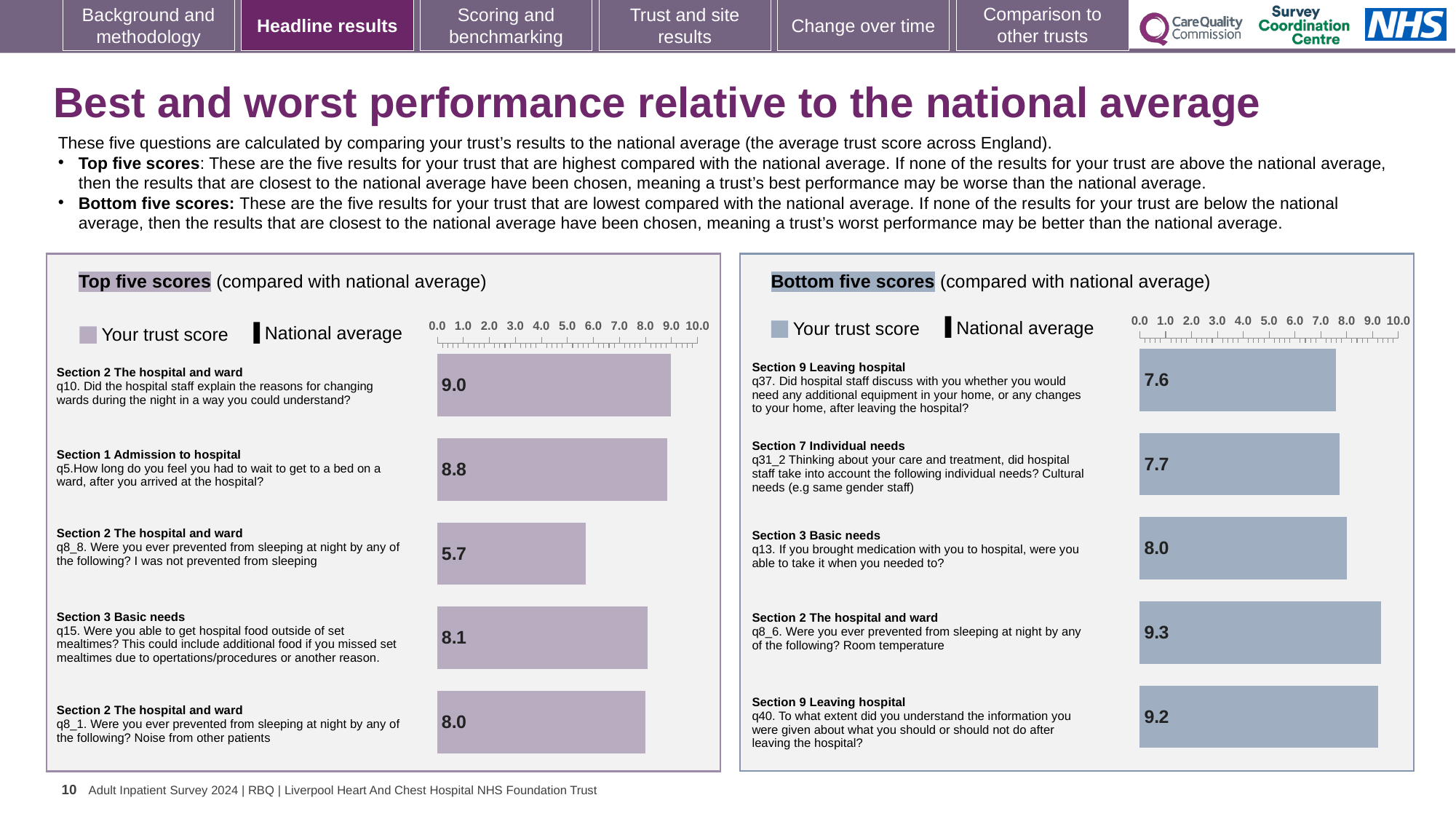
In the Bottom five scores chart, is the trust score for q13 (medication) larger or smaller than the trust score for q40 (understanding information after leaving hospital)? smaller In the Top five scores chart, how many questions are plotted? 5 In the Top five scores chart, which question has the lowest trust score? q8_8. Were you ever prevented from sleeping at night by any of the following? I was not prevented from sleeping In the Bottom five scores chart, what is the difference between the trust scores for q8_6 and q37? 1.7 In the Top five scores chart, what is the trust score for q10 (Did the hospital staff explain the reasons for changing wards during the night in a way you could understand?)? 9.0 How many entries does the legend of the Bottom five scores chart list? 2 In the Bottom five scores chart, which question has the lowest trust score? q37. Did hospital staff discuss with you whether you would need any additional equipment in your home, or any changes to your home, after leaving the hospital? In the Bottom five scores chart, which question has the highest trust score? q8_6. Were you ever prevented from sleeping at night by any of the following? Room temperature What type of chart is used in the Top five scores panel? bar chart In the Top five scores chart, what is the trust score for q5 (How long do you feel you had to wait to get to a bed on a ward)? 8.8 In the Bottom five scores chart, what is the trust score for q37 (Did hospital staff discuss with you whether you would need any additional equipment in your home)? 7.6 In the Top five scores chart, what is the difference between the trust scores for q10 and q8_8? 3.3